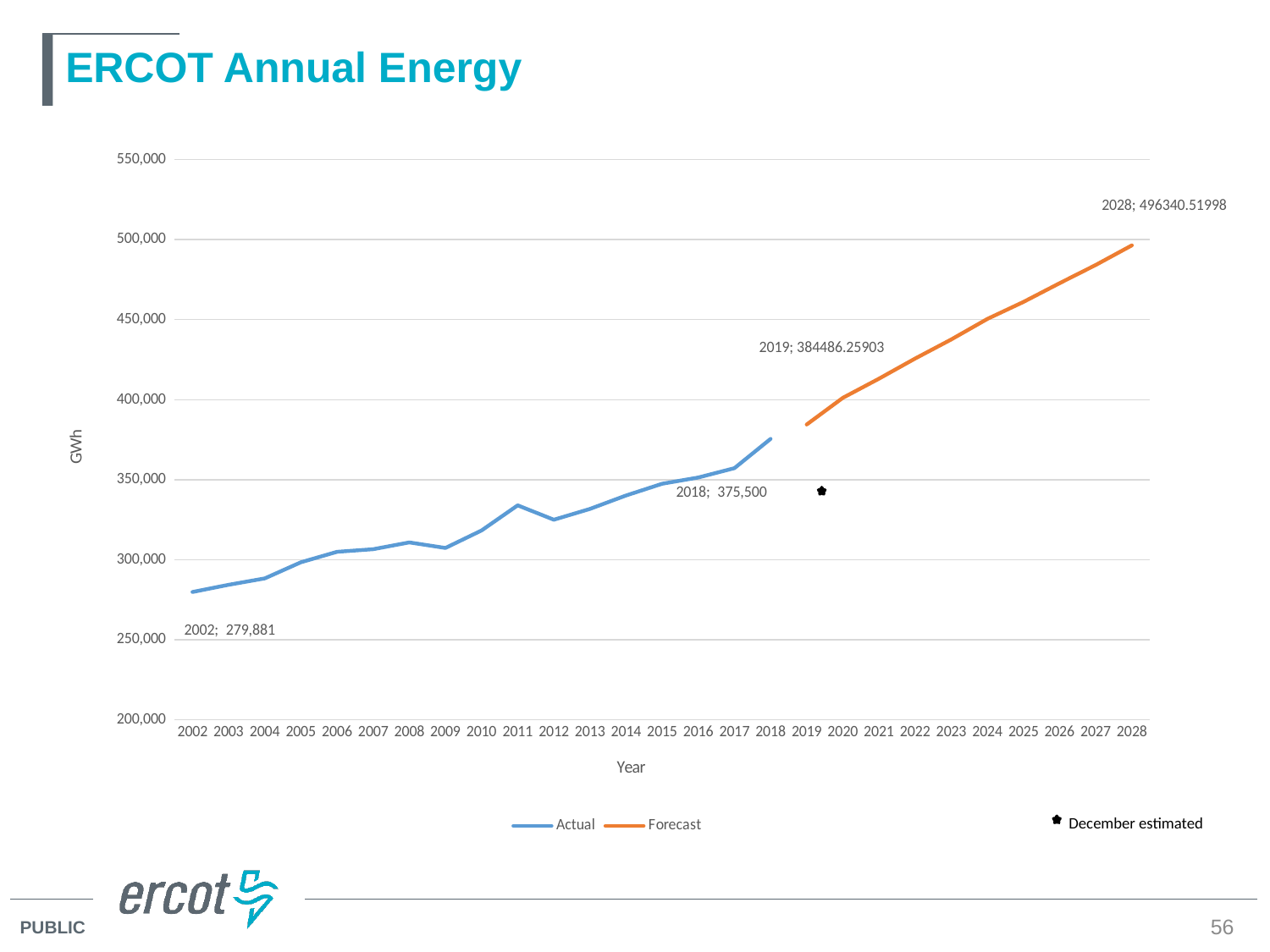
Is the Actual value for 2011 greater or less than 350,000? less What unit is shown on the y axis? GWh What is the Actual value for 2018? 375,500 What is the Forecast value for 2028? 496340.51998 Which is larger, the value for 2028 or the value for 2002? 2028 What is the Forecast value for 2019? 384486.25903 How many series does the legend list? 2 What is the Actual value for 2002? 279,881 What kind of chart is shown? line chart By how much did the Actual value increase from 2002 to 2018? 95,619 How many years are shown on the x axis? 27 Is the Forecast value for 2026 greater or less than 450,000? greater